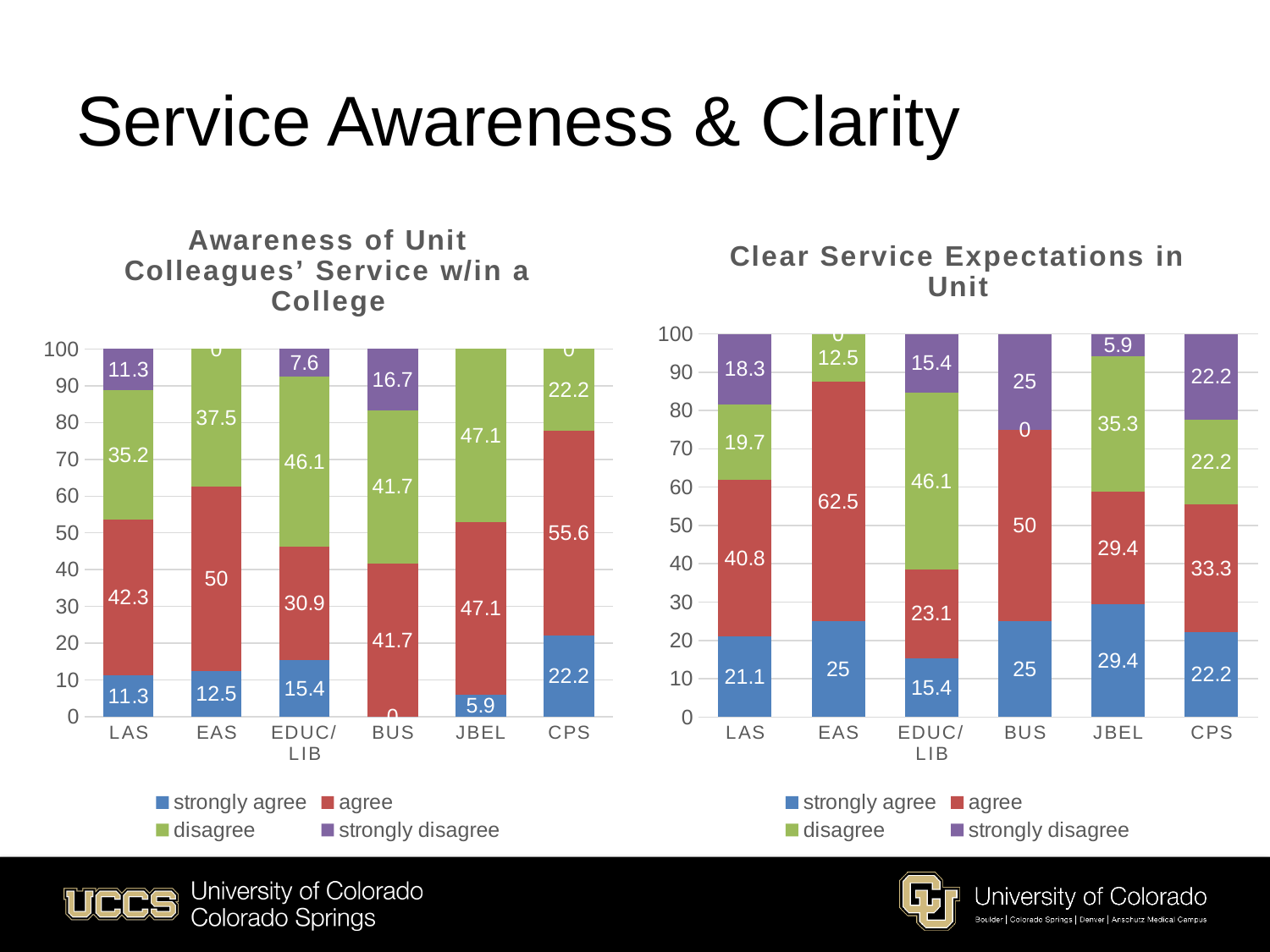
How many series does the legend of the 'Awareness of Unit Colleagues' Service w/in a College' chart list? 4 In the 'Clear Service Expectations in Unit' chart, what is the 'disagree' value for EDUC/LIB? 46.1 In the 'Awareness of Unit Colleagues' Service w/in a College' chart, which category has the highest 'strongly agree' value? CPS In the 'Awareness of Unit Colleagues' Service w/in a College' chart, what is the difference between the 'agree' values for CPS and EDUC/LIB? 24.7 In the 'Clear Service Expectations in Unit' chart, what is the 'agree' value for EAS? 62.5 How many categories are shown on the x axis of the 'Clear Service Expectations in Unit' chart? 6 In the 'Clear Service Expectations in Unit' chart, what is the combined total of 'strongly agree' and 'agree' for LAS? 61.9 In the 'Awareness of Unit Colleagues' Service w/in a College' chart, what is the 'agree' value for LAS? 42.3 In the 'Clear Service Expectations in Unit' chart, which category has the highest 'strongly agree' value? JBEL In the 'Awareness of Unit Colleagues' Service w/in a College' chart, what is the 'strongly disagree' value for BUS? 16.7 In the 'Awareness of Unit Colleagues' Service w/in a College' chart, which category has the lowest 'strongly agree' value? BUS In the 'Clear Service Expectations in Unit' chart, is the 'agree' value for BUS larger or smaller than the 'agree' value for CPS? larger